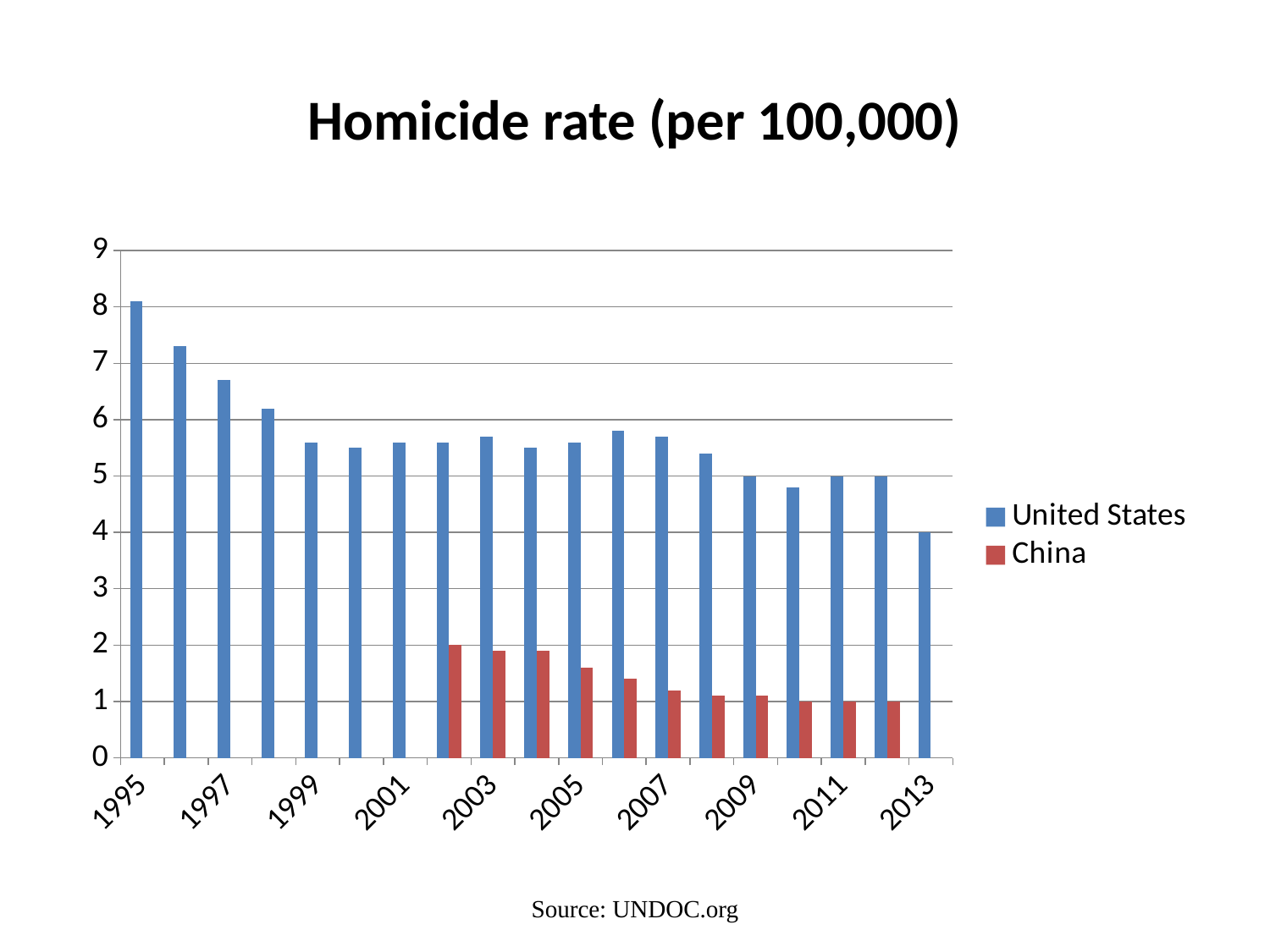
Is the United States homicide rate in 1995 greater or less than 7? greater Overall, does the United States homicide rate rise or fall from 1995 to 2013? Fall Which series does the legend show in red? China In which year is the United States homicide rate lowest? 2013 In which year is the United States homicide rate highest? 1995 What kind of chart is shown on the slide? Bar chart What is the China homicide rate in 2012? 1 What is the United States homicide rate in 2013? 4 Which is larger in 2005, the United States rate or the China rate? United States Is the China homicide rate in 2005 greater or less than 2? less What is the title of the chart? Homicide rate (per 100,000) How many series does the legend list? 2